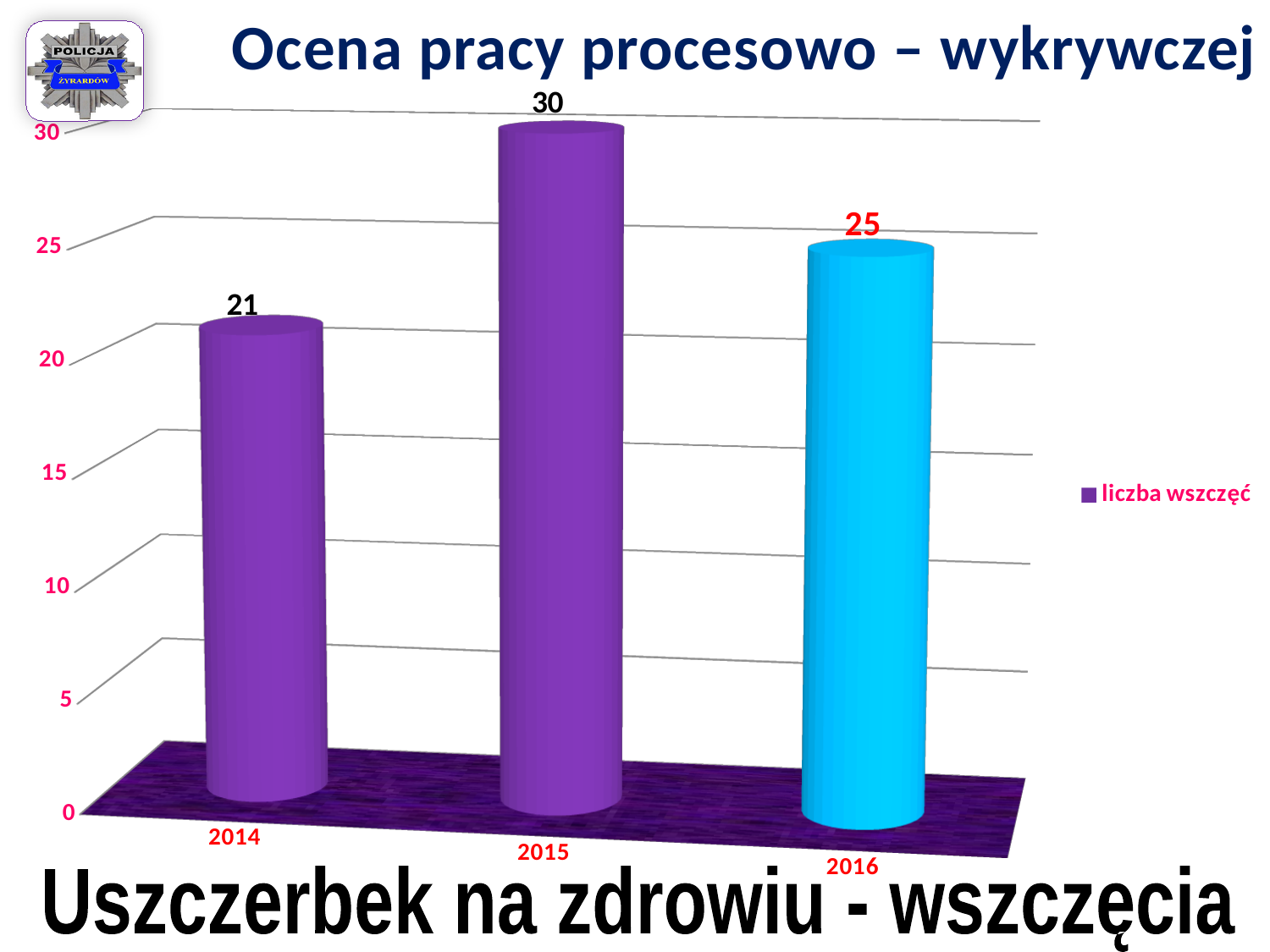
What kind of chart is shown on the slide? bar chart What is the difference between the values for 2015 and 2014? 9 Which year has the lowest value? 2014 What is the value for 2015? 30 Which is larger, the value for 2016 or the value for 2014? 2016 How many series does the legend list? 1 What is the value for 2016? 25 How many years are shown on the chart? 3 Which year has the highest value? 2015 What series name is shown in the legend? liczba wszczęć What is the value for 2014? 21 What is the difference between the values for 2016 and 2014? 4